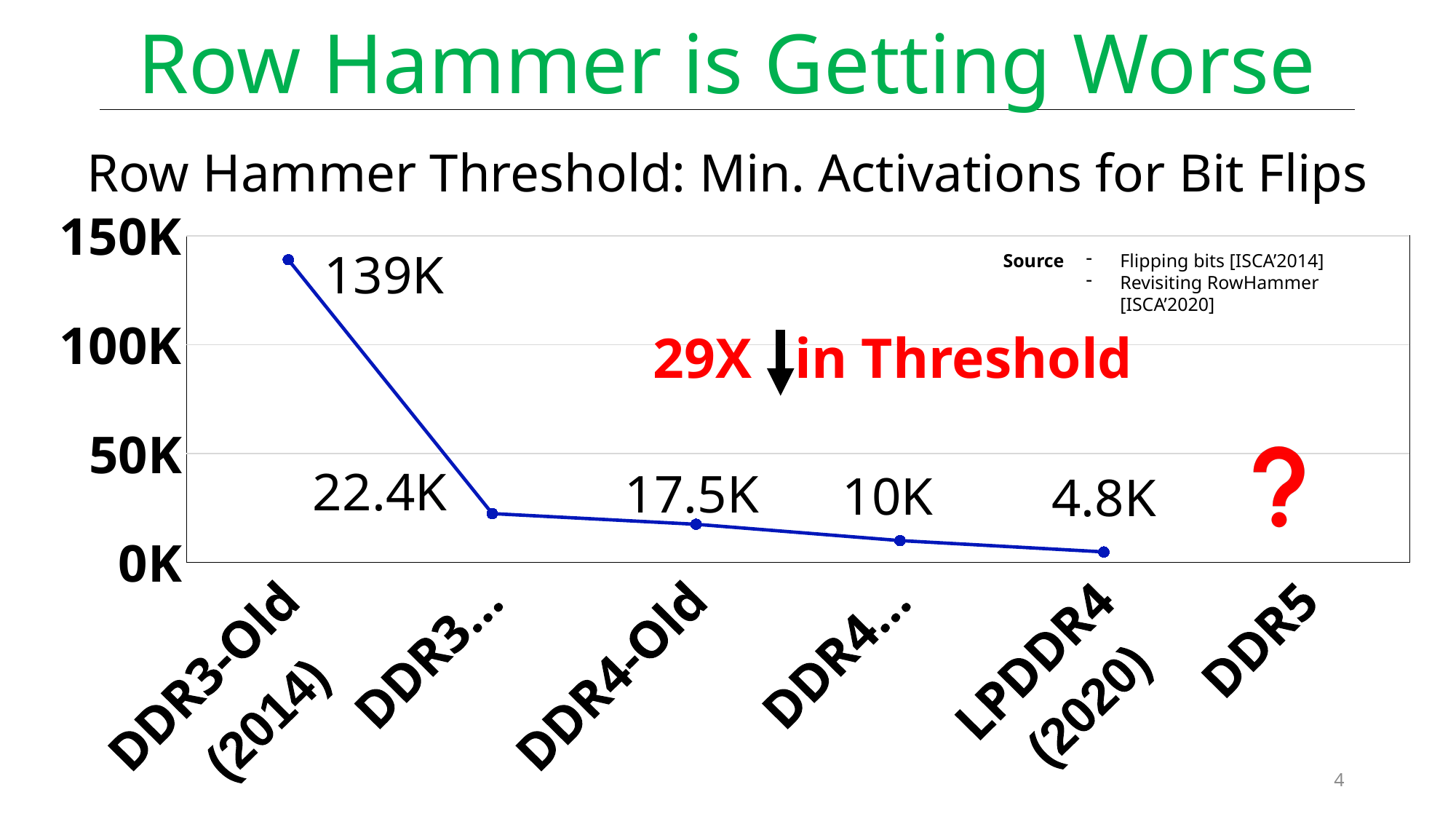
What is the Row Hammer threshold value shown for DDR4-Old? 17.5K What is the Row Hammer threshold value shown for DDR3-Old (2014)? 139K What is the Row Hammer threshold value shown for LPDDR4 (2020)? 4.8K What is the difference between the threshold for DDR4-Old and LPDDR4 (2020)? 12.7K Which has a larger threshold, DDR4-Old or LPDDR4 (2020)? DDR4-Old Is the value for DDR4-Old greater or less than 50K? less What is the difference between the threshold for DDR3-Old (2014) and LPDDR4 (2020)? 134.2K Do the threshold values rise or fall from left to right along the x axis? fall Which category with a plotted value has the lowest Row Hammer threshold? LPDDR4 (2020) What kind of chart is shown on the slide? line chart How many data points are plotted on the line? 5 Which category has the highest Row Hammer threshold on the chart? DDR3-Old (2014)